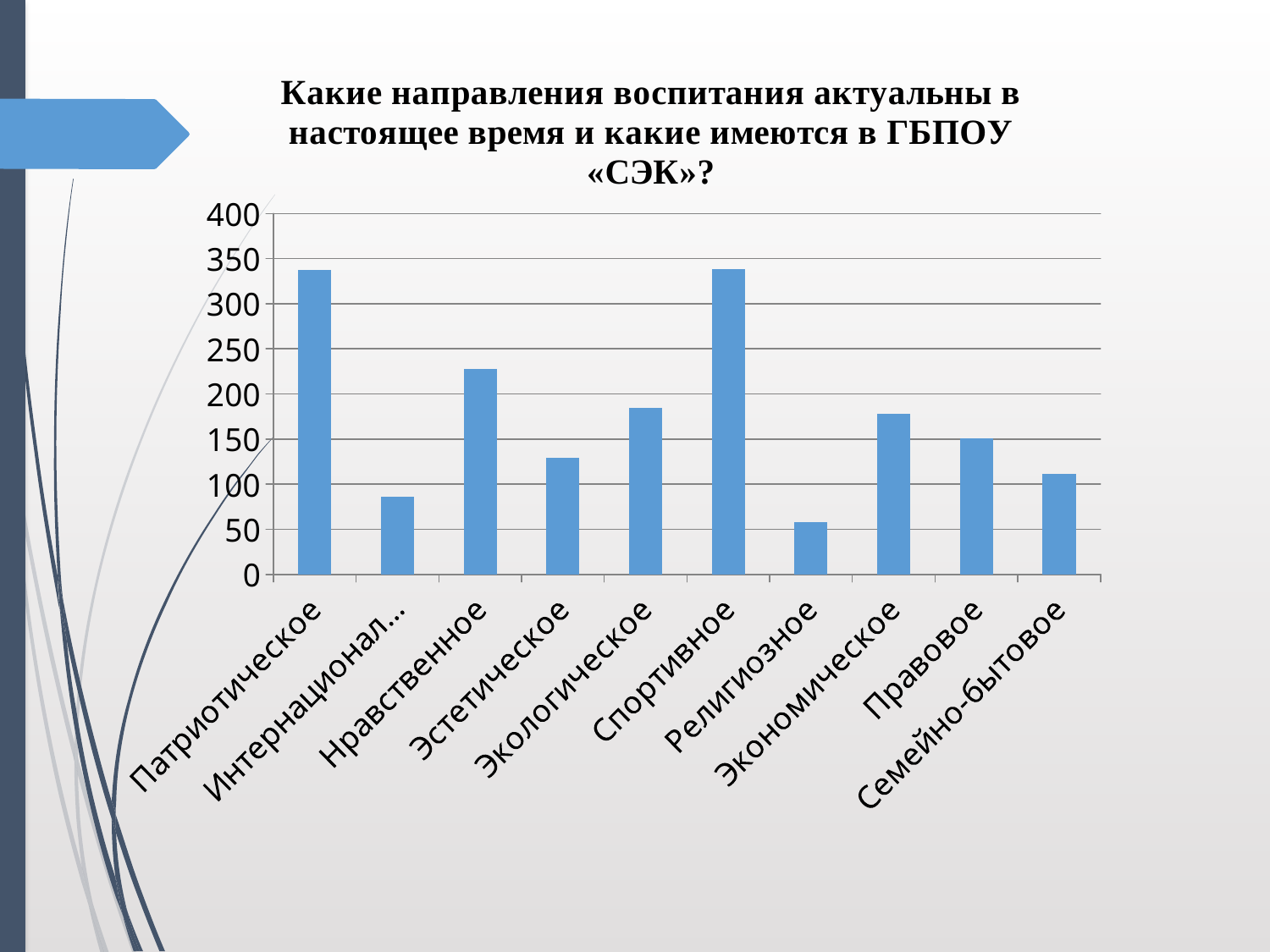
Is the value for Эстетическое greater or less than 150? less Is the value for Религиозное greater or less than 100? less How many categories are shown on the x axis of the chart? 10 What kind of chart is shown on the slide? bar chart Is the value for Семейно-бытовое greater or less than 100? greater Which has a larger value, Экономическое or Семейно-бытовое? Экономическое Which category has the lowest value in the chart? Религиозное Which has a larger value, Нравственное or Экологическое? Нравственное What is the title of the chart on the slide? Какие направления воспитания актуальны в настоящее время и какие имеются в ГБПОУ «СЭК»?